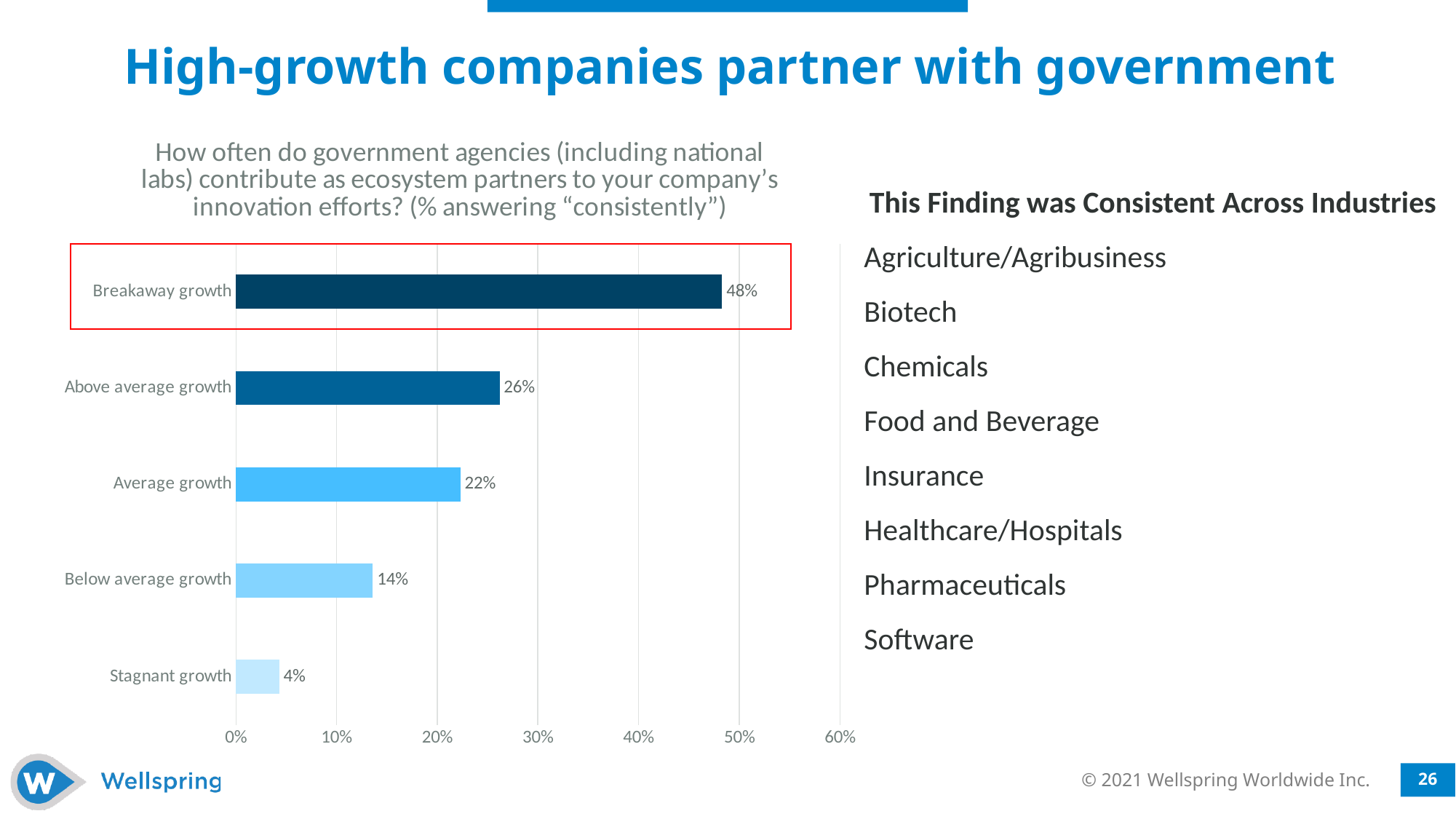
What is the difference between the values for Breakaway growth and Above average growth? 22% What type of chart is shown on the slide? Bar chart Which bar on the chart is outlined with a red box? Breakaway growth What is the difference between the values for Average growth and Below average growth? 8% Which growth category has the lowest value? Stagnant growth Which is larger, the value for Average growth or the value for Below average growth? Average growth Is the value for Breakaway growth greater or less than 40%? greater How many growth categories are shown in the chart? 5 What is the value shown for Above average growth? 26% Which growth category has the highest value? Breakaway growth What percentage of Breakaway growth companies answered "consistently"? 48% What is the value shown for Stagnant growth? 4%